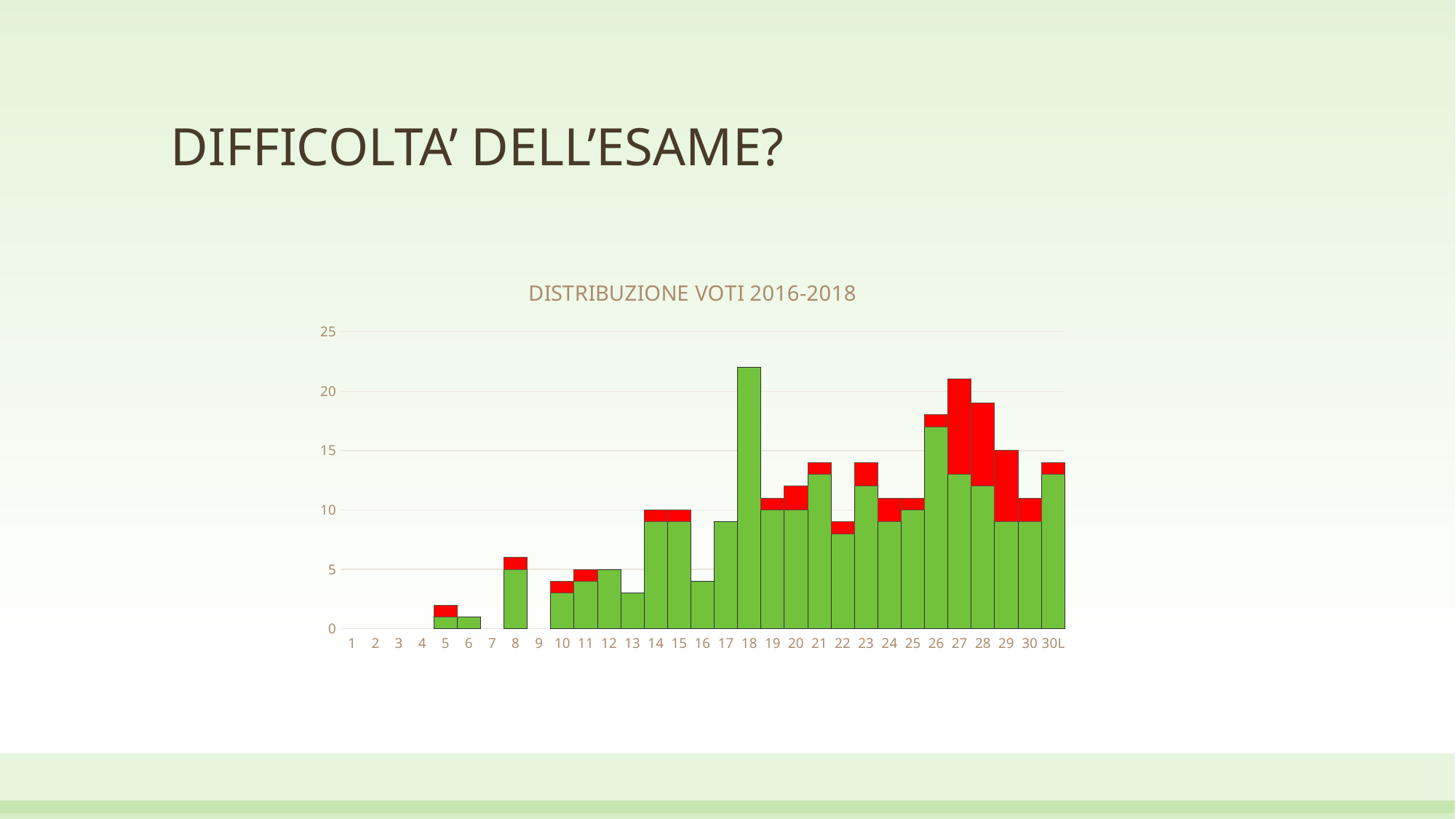
Which has the larger total bar, category 18 or category 13? 18 Is the total value for category 13 greater or less than 5? less Is the total value for category 26 greater or less than 15? greater What is the title of the chart? DISTRIBUZIONE VOTI 2016-2018 How many categories on the x axis have no bar at all? 6 Is the total value for category 5 greater or less than 5? less What two colours are used for the bar segments in the chart? green and red How many categories are shown on the x axis of the chart? 31 What kind of chart is shown on the slide? bar chart Which category has the tallest green bar segment? 18